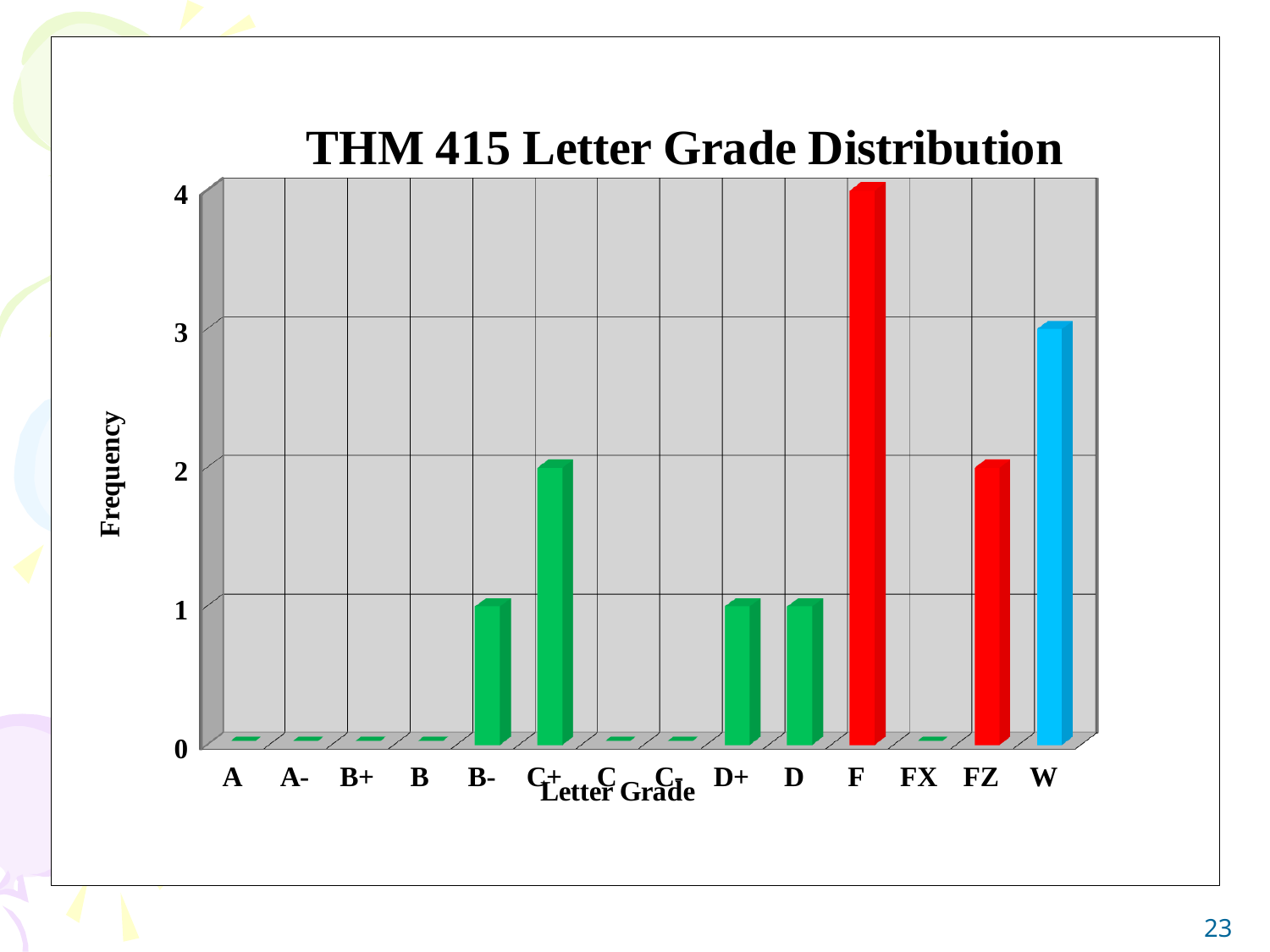
What is the frequency for letter grade F? 4 Is the frequency for W greater or less than 2? greater How many letter grade categories are shown on the x axis? 14 What is the difference between the frequency for F and the frequency for W? 1 What is the frequency for letter grade B-? 1 What is the frequency for letter grade C+? 2 What is the title of the chart? THM 415 Letter Grade Distribution What is the frequency for letter grade W? 3 What is the frequency for letter grade FZ? 2 Which has a higher frequency, C+ or D+? C+ Which letter grade has the highest frequency? F What kind of chart is shown on the slide? Bar chart